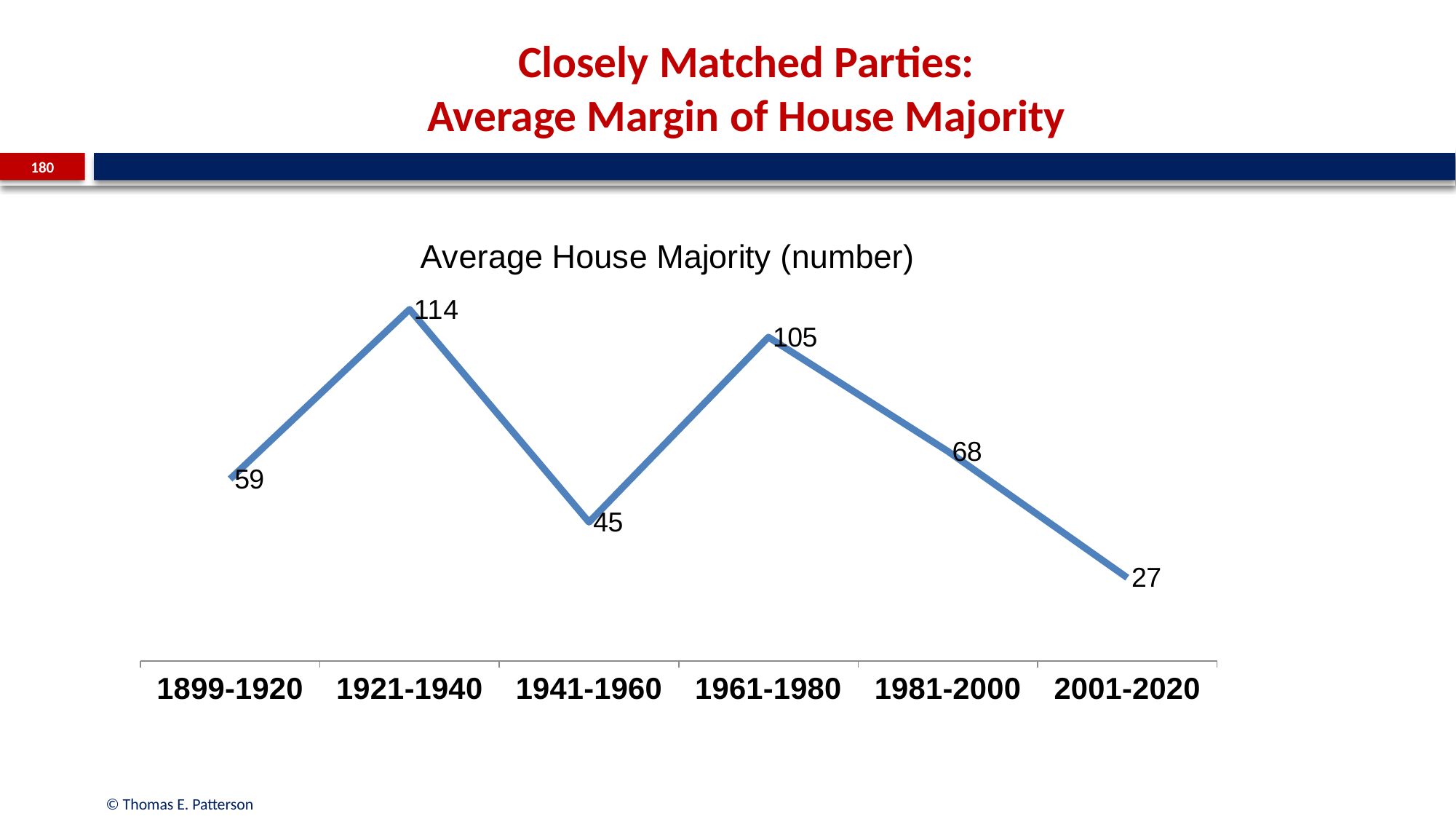
Which period has a larger average House majority, 1899-1920 or 1941-1960? 1899-1920 What is the title of the chart? Average House Majority (number) What kind of chart is shown on the slide? Line chart What is the average House majority for 1899-1920? 59 What is the difference between the average House majority for 1921-1940 and 1941-1960? 69 What is the average House majority for 2001-2020? 27 What is the difference between the average House majority for 1981-2000 and 2001-2020? 41 What is the average House majority for 1921-1940? 114 Which period has the lowest average House majority? 2001-2020 Does the average House majority rise or fall from 1961-1980 to 2001-2020? Fall Which period has the highest average House majority? 1921-1940 How many periods are plotted on the chart? 6